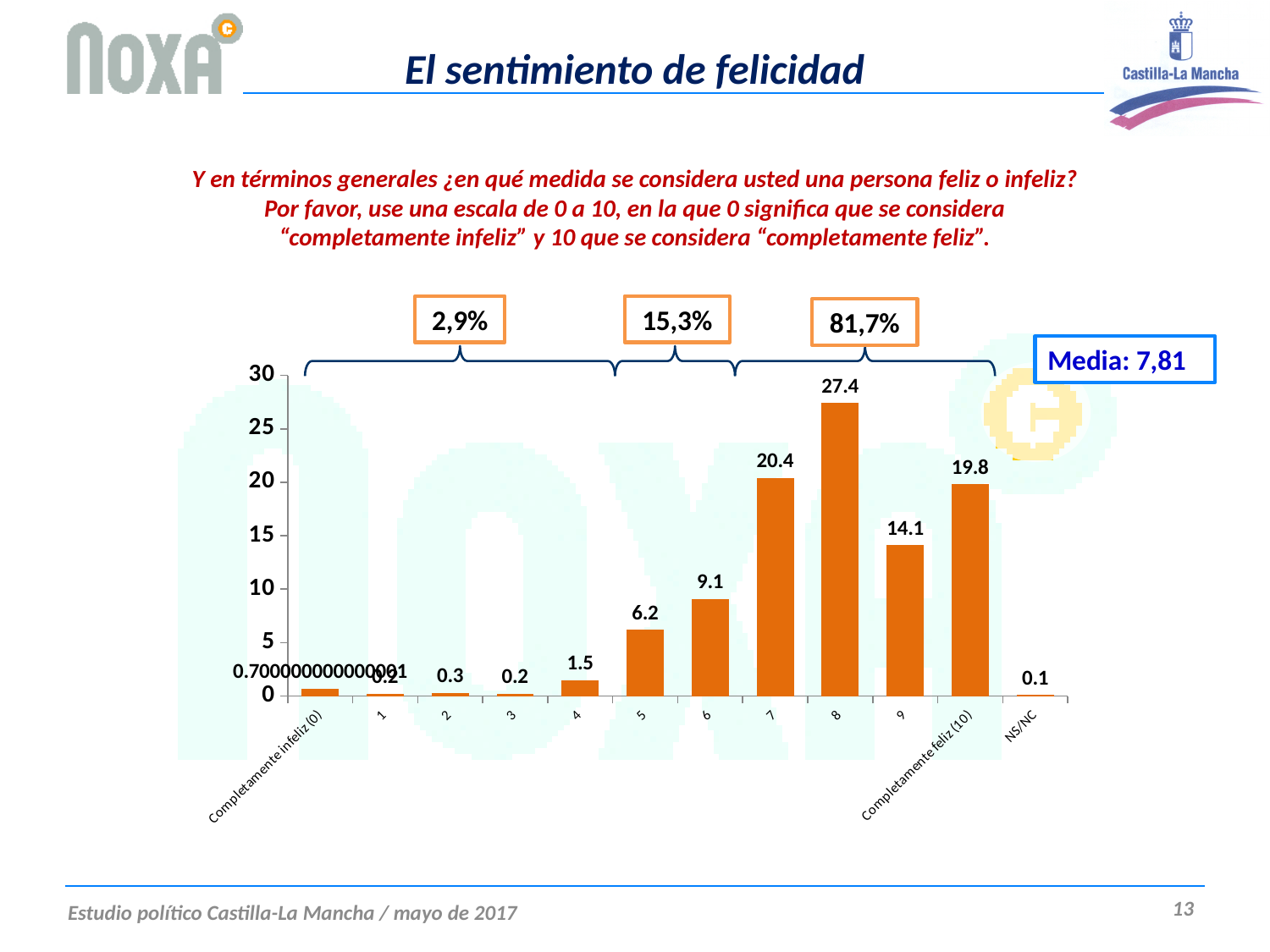
What kind of chart is shown on the slide? bar chart Is the value for category 7 greater or less than 20? greater How many categories are shown on the x axis? 12 Which is larger, the value for category 6 or the value for category 9? 9 What is the value for category 5? 6.2 What is the value for "Completamente feliz (10)"? 19.8 What is the value for category 7? 20.4 What is the mean (Media) value shown in the box on the slide? 7,81 Which category has the highest value? 8 Which category has the lowest value? NS/NC What is the value for category 8? 27.4 What is the difference between the values for category 8 and category 9? 13.3